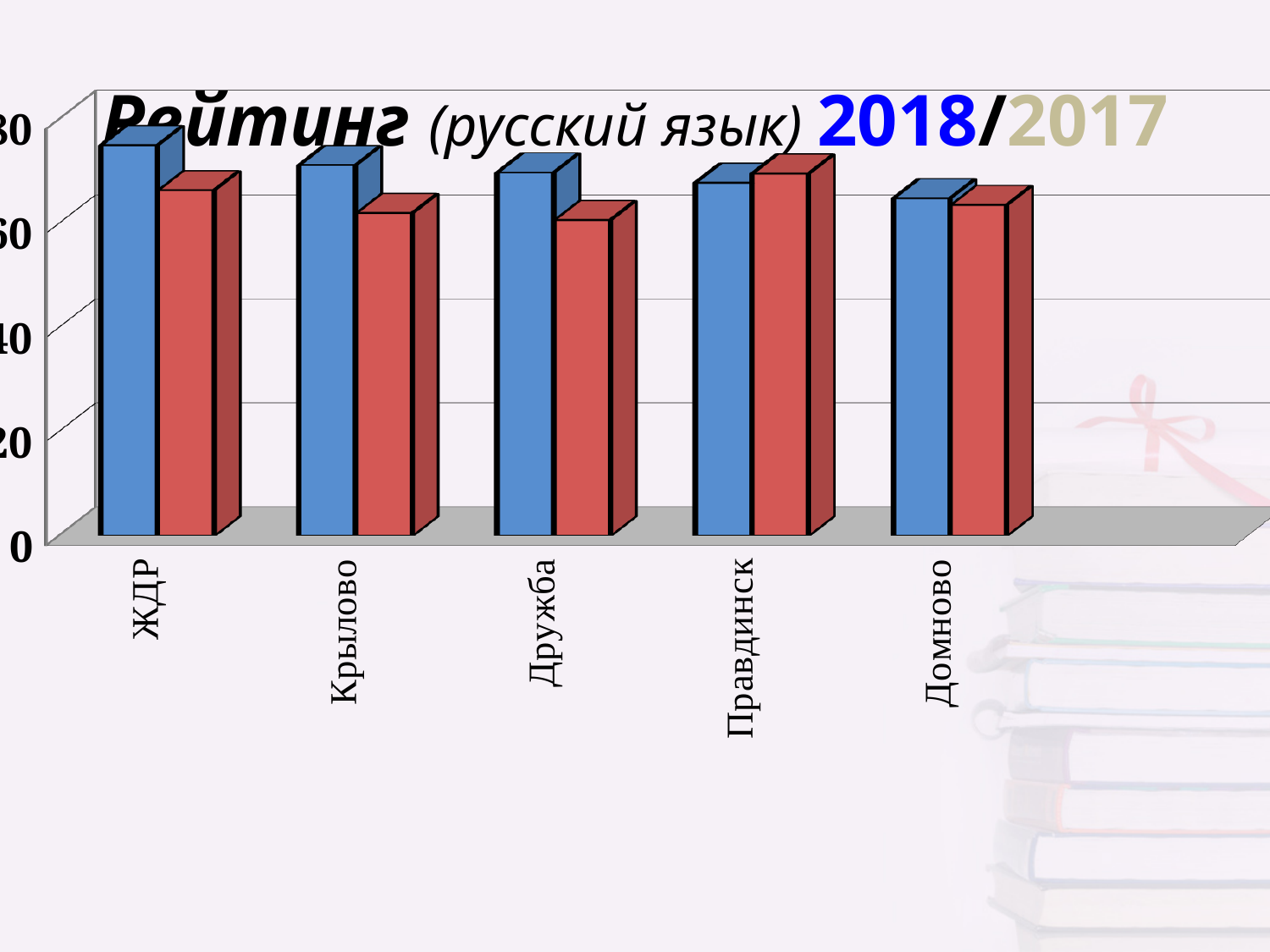
What subject is named in the chart title? русский язык Do the blue bars rise or fall from left to right across the categories? fall How many series of bars are plotted for each category? 2 Which category has the tallest blue bar? ЖДР For ЖДР, which bar is taller, the blue one or the red one? blue Is the value of the blue bar for Домново greater or less than 80? less What kind of chart is shown on the slide? bar chart For Дружба, which bar is taller, the blue one or the red one? blue Is the value of the blue bar for ЖДР greater or less than 60? greater How many categories are shown on the x axis of the chart? 5 Is the value of the red bar for Крылово greater or less than 40? greater For Крылово, which bar is taller, the blue one or the red one? blue